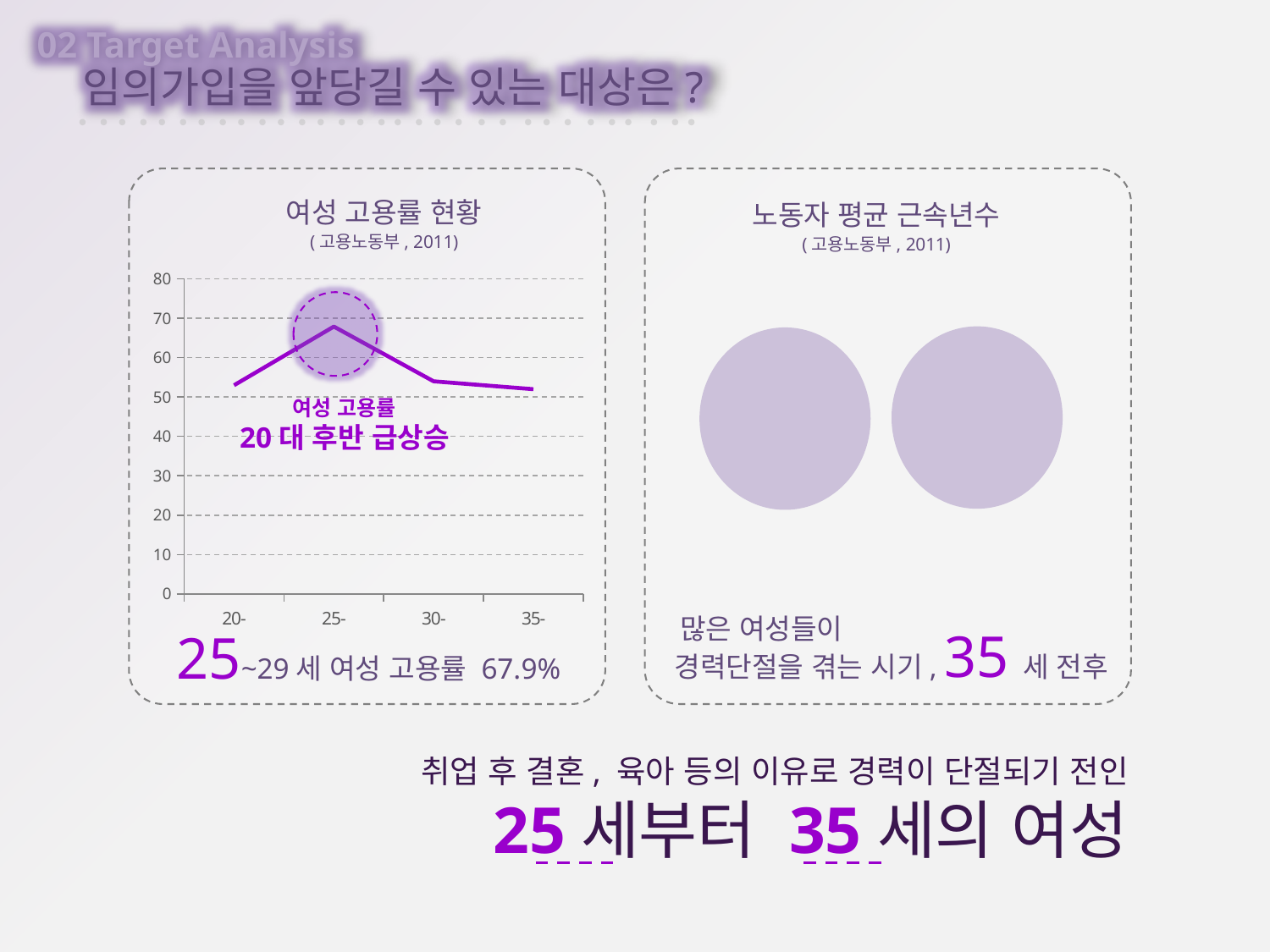
According to the slide, what is the employment rate of women aged 25~29? 67.9% In the 여성 고용률 현황 chart, is the value for 35- greater or less than 60? less What is the highest value shown on the y axis of the 여성 고용률 현황 chart? 80 How many age categories are shown on the x axis of the 여성 고용률 현황 chart? 4 In the 여성 고용률 현황 chart, does the line rise or fall from 25- to 30-? fall In the 여성 고용률 현황 chart, is the value for 30- greater or less than 60? less What kind of chart is shown under the title 여성 고용률 현황? line chart What source and year are cited under the title of the 여성 고용률 현황 chart? 고용노동부, 2011 In the 여성 고용률 현황 chart, is the value for 25- greater or less than 60? greater In the 여성 고용률 현황 chart, which age category has the highest employment rate? 25- In the 여성 고용률 현황 chart, which is larger, the value for 25- or the value for 30-? 25-